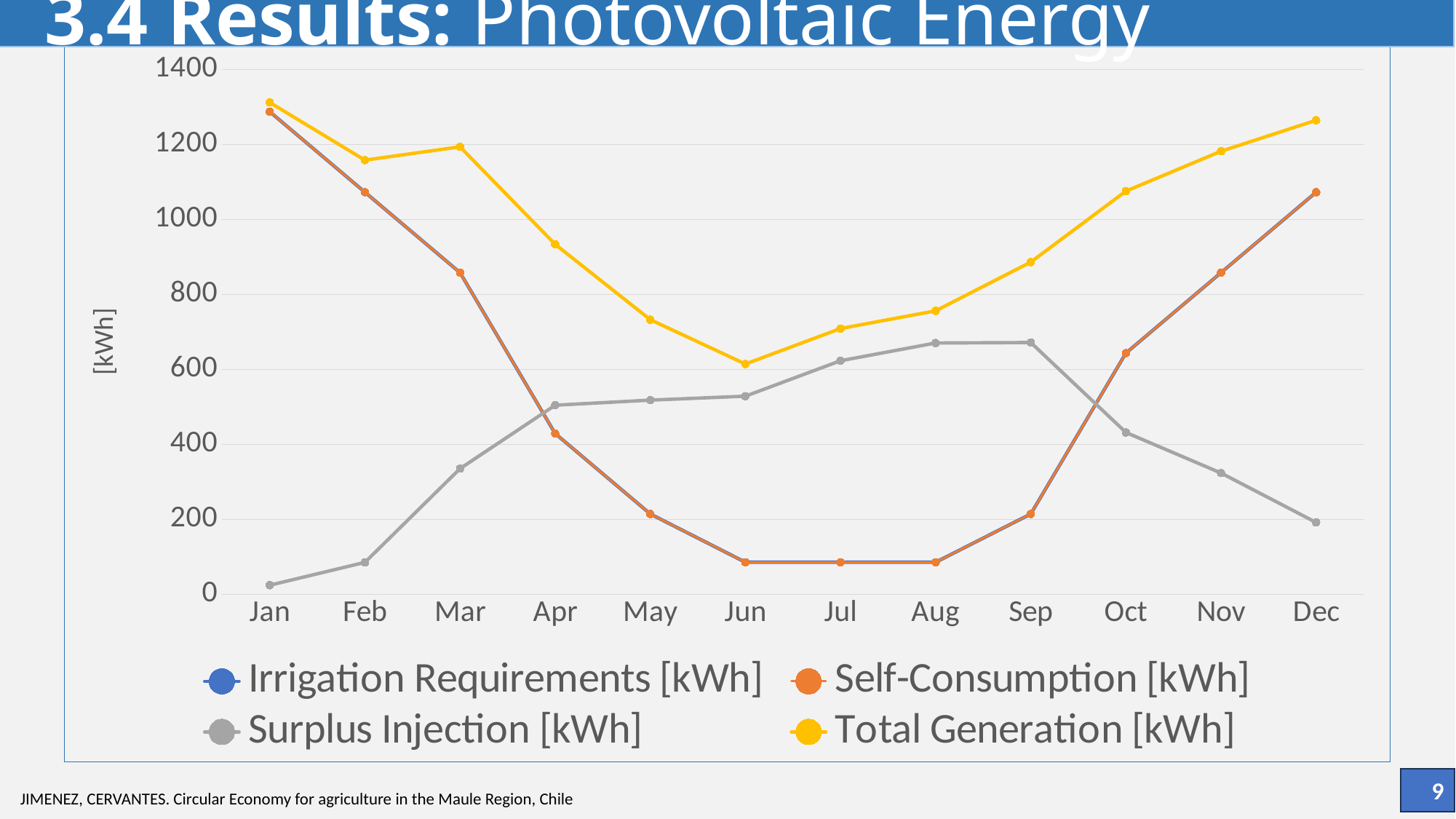
Is the value for Self-Consumption [kWh] in Jun greater or less than 200? less What kind of chart is shown on the slide? line chart How many months are plotted along the x axis? 12 How many series does the legend list? 4 What label is shown on the y axis? [kWh] Is the value for Total Generation [kWh] in Jan greater or less than 1200? greater In which month is Surplus Injection [kWh] lowest? Jan Is the value for Surplus Injection [kWh] in Dec greater or less than 400? less In Oct, which is larger: Self-Consumption [kWh] or Surplus Injection [kWh]? Self-Consumption [kWh] Does Total Generation [kWh] rise or fall from Jan to Jun? fall In which month is Total Generation [kWh] highest? Jan In which month is Total Generation [kWh] lowest? Jun